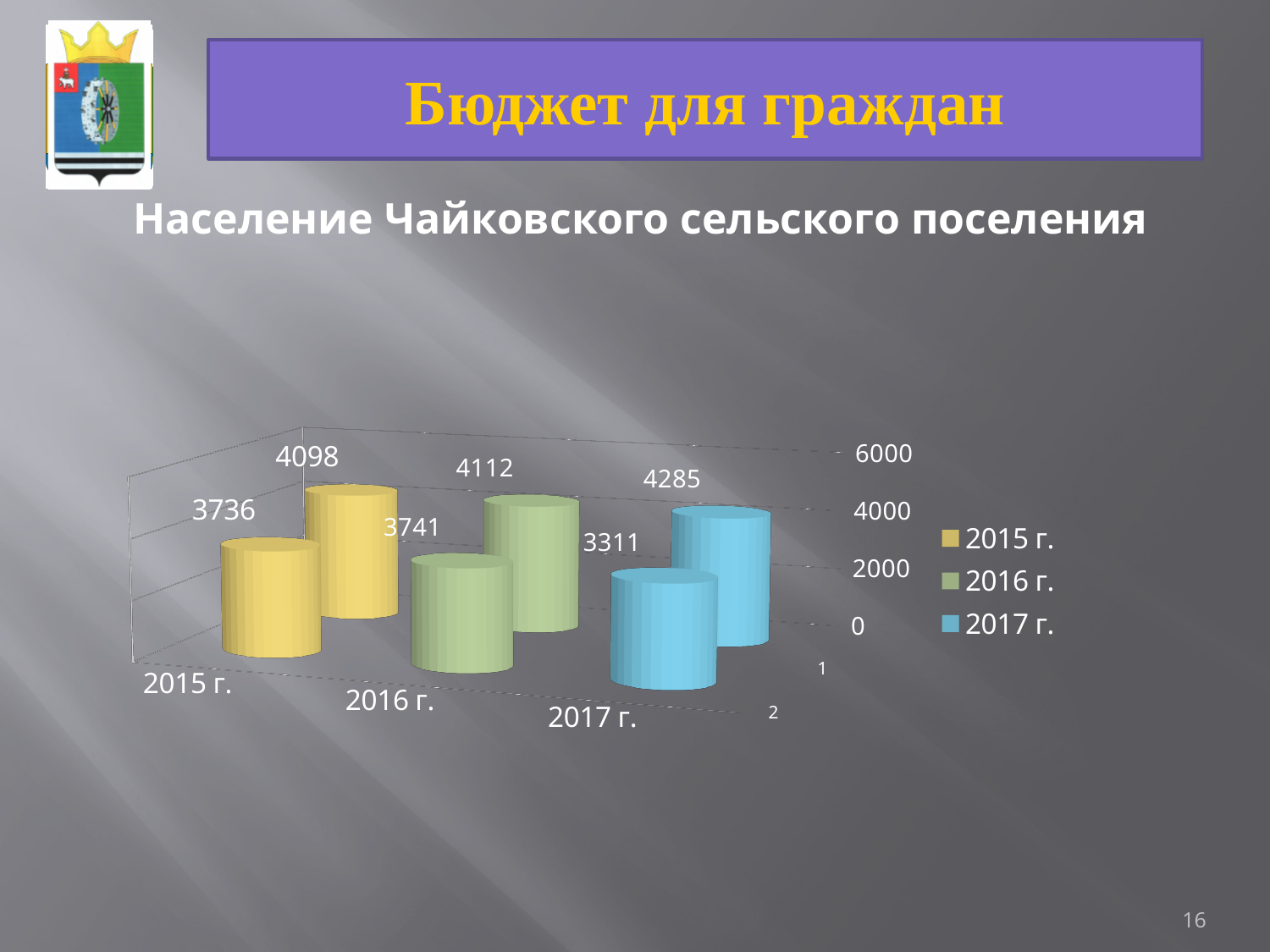
What kind of chart is shown on the slide? bar chart How many entries does the chart legend list? 3 What is the title of the chart on the slide? Население Чайковского сельского поселения Is the front-row value for 2017 г. greater or less than 4000? less Which is larger: the back-row value for 2016 г. or the back-row value for 2015 г.? 2016 г. What is the back (row 2) value for 2015 г.? 4098 What is the difference between the back-row value (4285) and the front-row value (3311) for 2017 г.? 974 What is the back (row 2) value for 2017 г.? 4285 What is the front (row 1) value for 2016 г.? 3741 Which year has the lowest front-row (row 1) value? 2017 г. What is the front (row 1) value for 2015 г.? 3736 Which year has the highest back-row (row 2) value? 2017 г.